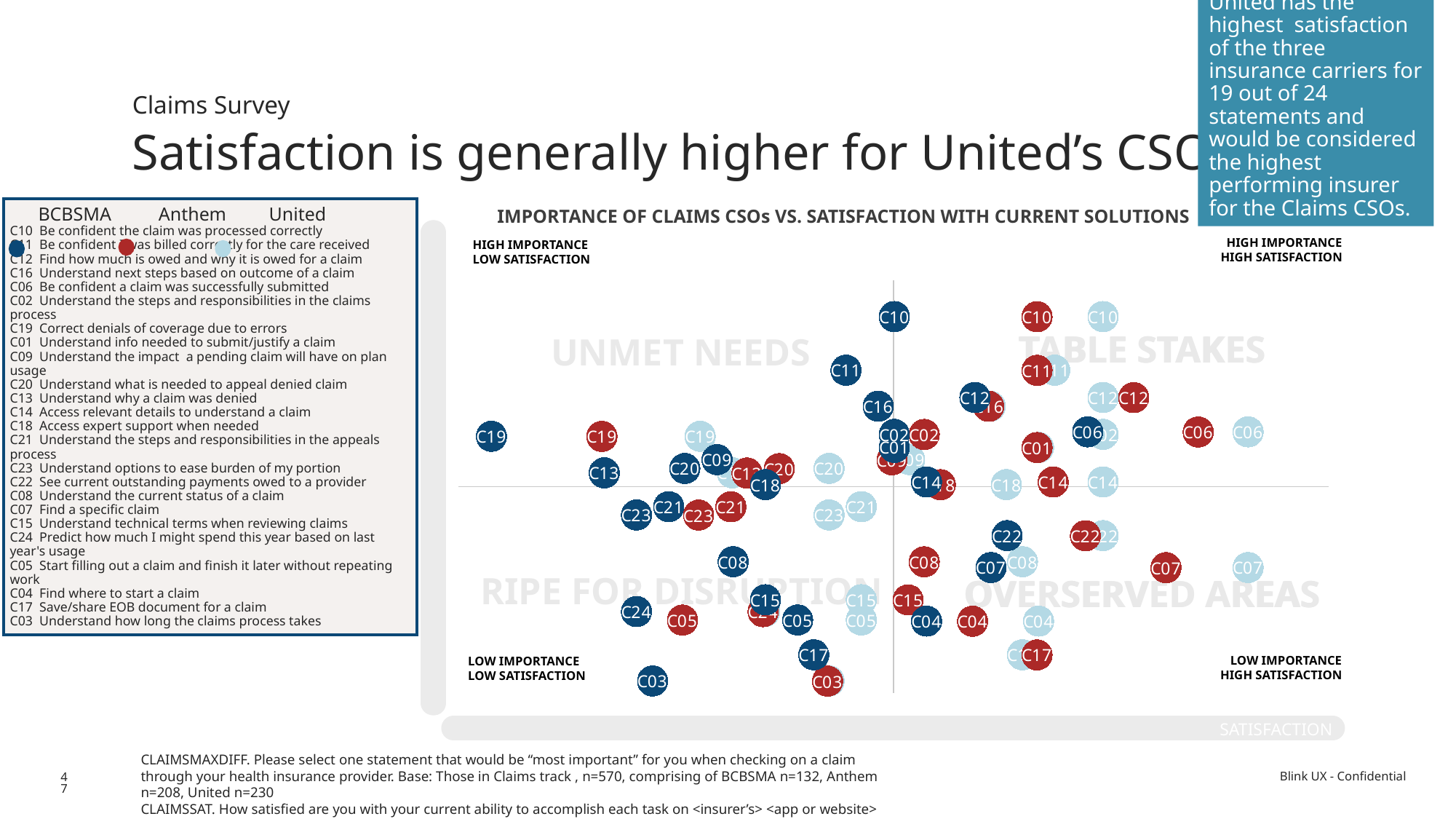
Which quadrant label appears in the upper-right (high importance, high satisfaction) area of the chart? TABLE STAKES Which statement code is plotted with the lowest importance in the chart? C03 Which three insurers are plotted in the chart? BCBSMA, Anthem, United For statement C06, is satisfaction higher for BCBSMA or United? United How many claims statements (C-codes) are listed in the chart's key? 24 What kind of chart is shown on the slide? Scatter chart For statement C10, which insurer has the highest satisfaction? United For statement C19, which insurer has the lowest satisfaction? BCBSMA How many insurers (series) does the chart's legend list? 3 What is the title of the chart? IMPORTANCE OF CLAIMS CSOs VS. SATISFACTION WITH CURRENT SOLUTIONS Which statement code is plotted with the highest importance across all three insurers? C10